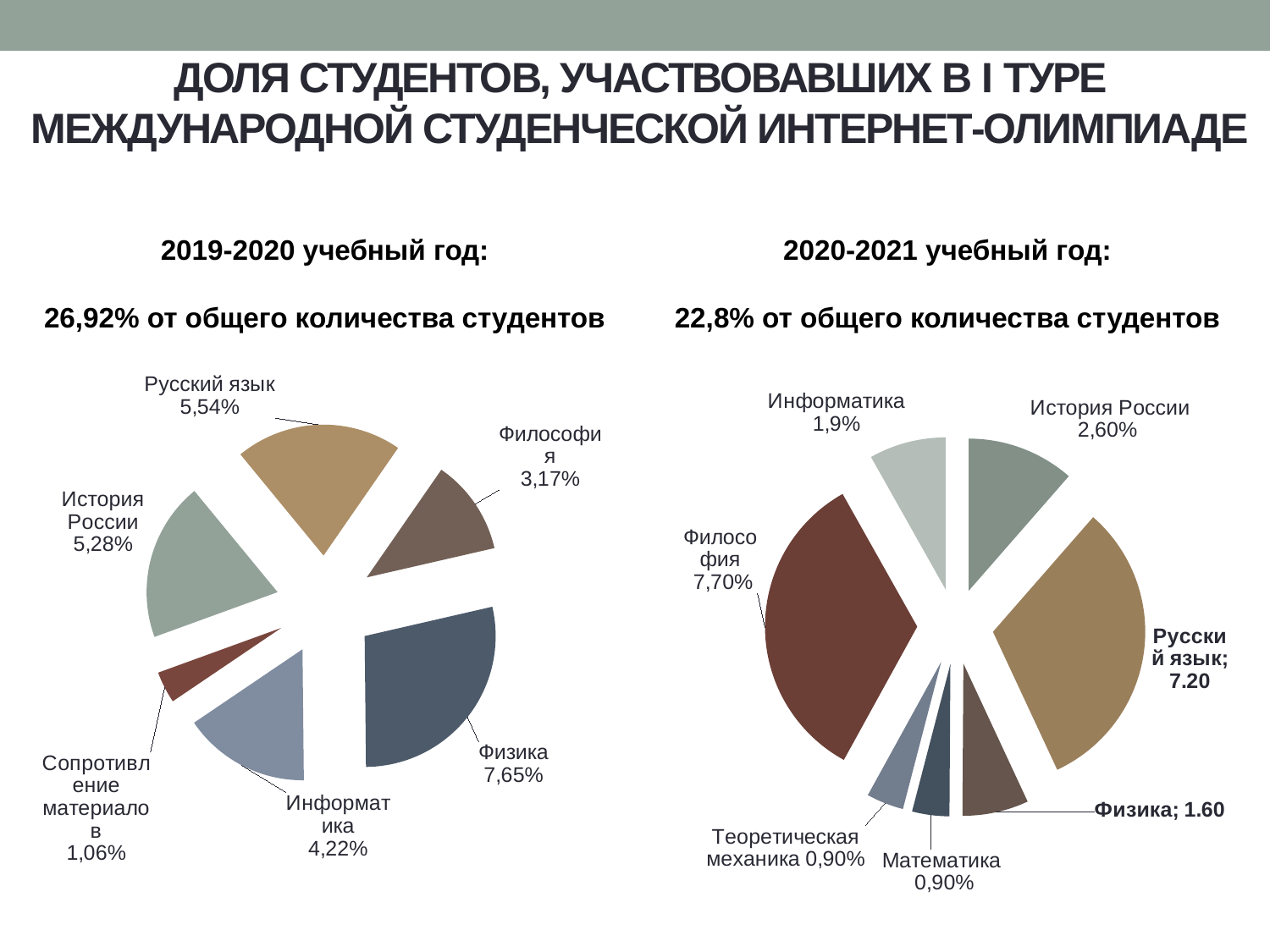
What kind of chart is used for the 2019-2020 учебный год data? Pie chart How many slices does the 2019-2020 учебный год pie chart have? 6 In the 2019-2020 учебный год chart, which is larger: Философия or Информатика? Информатика In the 2019-2020 учебный год chart, which category has the largest share? Физика In the 2020-2021 учебный год chart, what is the value for История России? 2,60% In the 2020-2021 учебный год chart, what is the value for Математика? 0,90% In the 2019-2020 учебный год chart, what is the value for Русский язык? 5,54% In the 2019-2020 учебный год chart, what is the value for Физика? 7,65% In the 2019-2020 учебный год chart, what is the difference between Физика and Русский язык? 2,11% In the 2019-2020 учебный год chart, which category has the smallest share? Сопротивление материалов How many slices does the 2020-2021 учебный год pie chart have? 7 In the 2020-2021 учебный год chart, what is the value for Философия? 7,70%